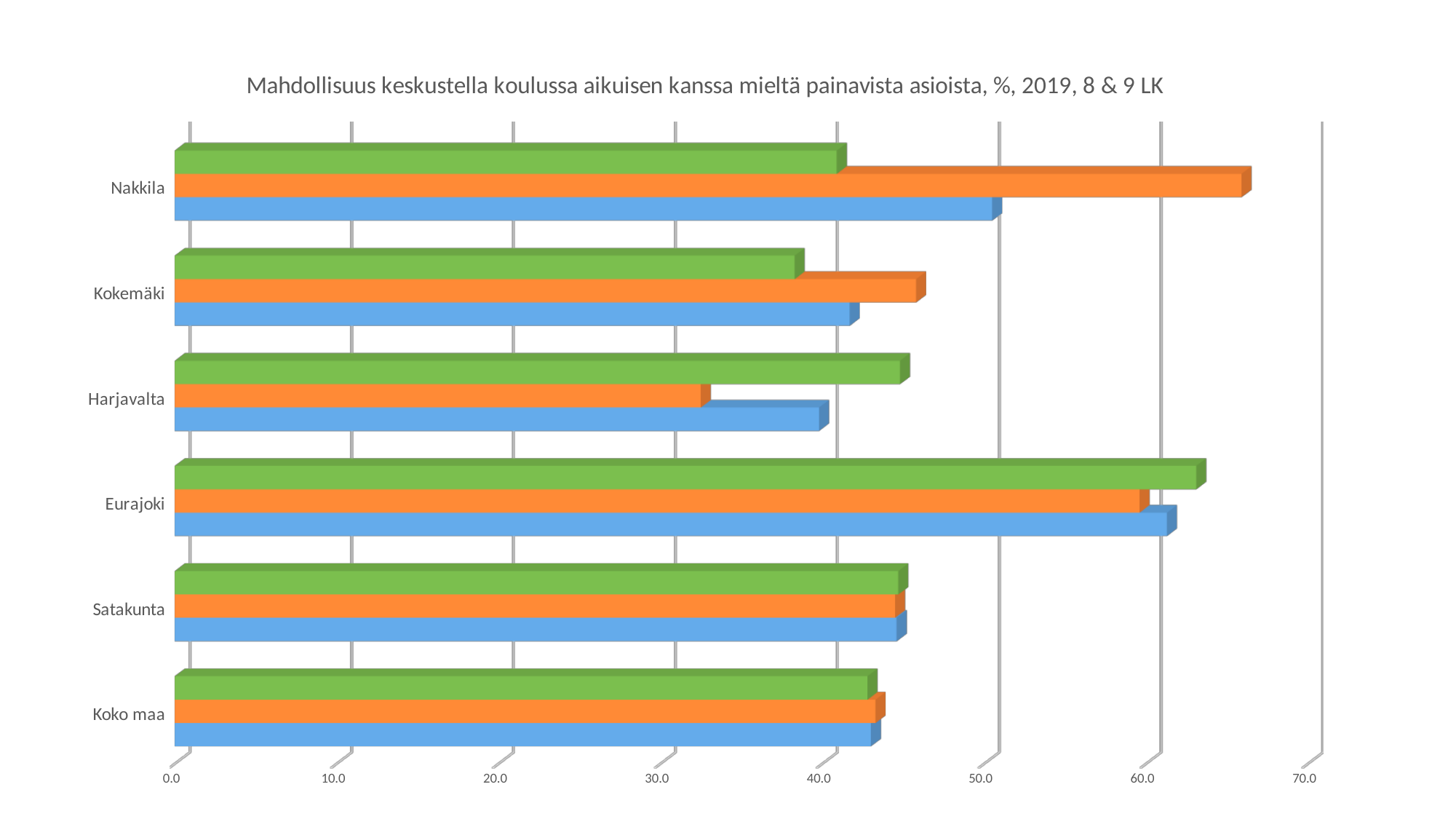
Is the value of the orange bar for Nakkila greater or less than 60? greater Is the value of the green bar for Eurajoki greater or less than 60? greater What kind of chart is shown on the slide? bar chart For Harjavalta, which is larger: the green bar or the orange bar? green bar Is the value of the blue bar for Satakunta greater or less than 40? greater How many bars are shown for each category in the chart? 3 What is the title of the chart? Mahdollisuus keskustella koulussa aikuisen kanssa mieltä painavista asioista, %, 2019, 8 & 9 LK Which category has the shortest orange bar? Harjavalta Which category has the longest orange bar? Nakkila How many categories are shown on the vertical axis of the chart? 6